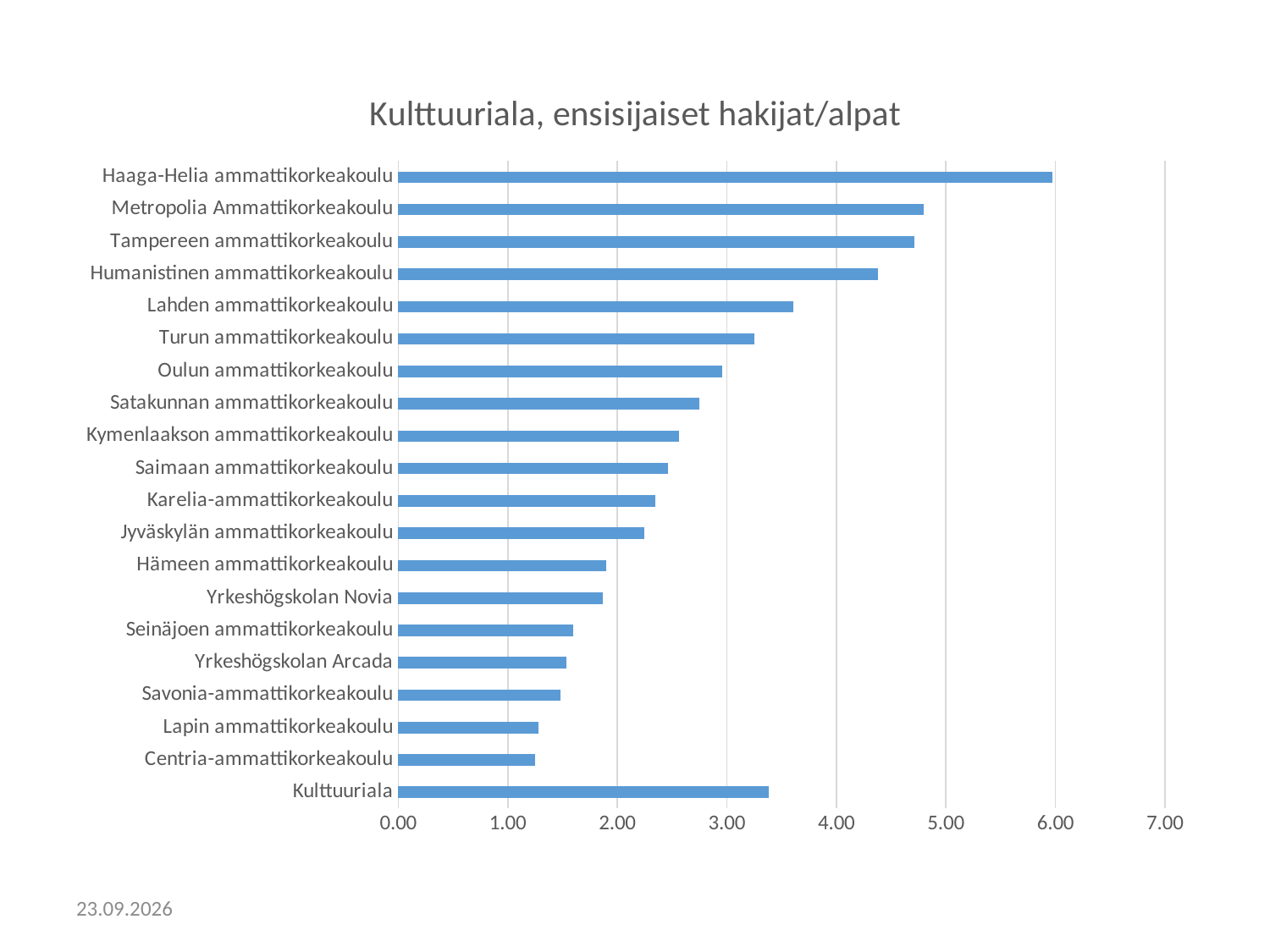
Is the value for Lahden ammattikorkeakoulu greater or less than 3.00? greater Which has a larger value, Turun ammattikorkeakoulu or Satakunnan ammattikorkeakoulu? Turun ammattikorkeakoulu Is the value for Metropolia Ammattikorkeakoulu greater or less than 4.00? greater Which has a larger value, Tampereen ammattikorkeakoulu or Lahden ammattikorkeakoulu? Tampereen ammattikorkeakoulu How many categories (bars) are shown in the chart? 20 Is the value for Haaga-Helia ammattikorkeakoulu greater or less than 5.00? greater What type of chart is shown on the slide? bar chart Which category has the highest value? Haaga-Helia ammattikorkeakoulu What is the title of the chart? Kulttuuriala, ensisijaiset hakijat/alpat